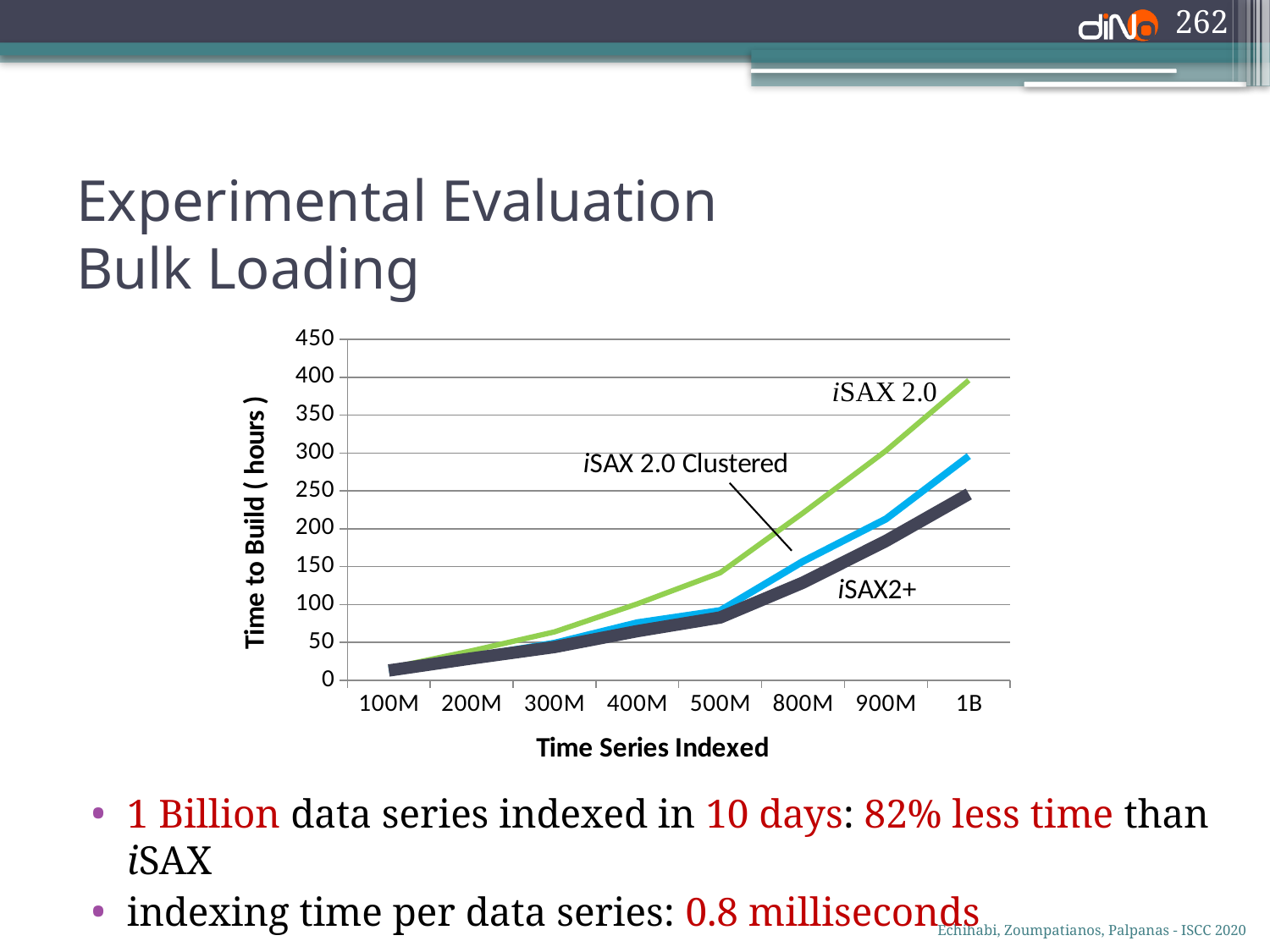
Do the values for iSAX 2.0 rise or fall as the number of time series indexed increases? rise How many categories are shown on the x axis of the chart? 8 What is the title of the y axis of the chart? Time to Build ( hours ) At 1B, which is larger: the value for iSAX 2.0 or the value for iSAX2+? iSAX 2.0 Is the value for iSAX2+ at 100M greater or less than 50? less What kind of chart is shown on the slide? line chart At 1B time series indexed, which series has the lowest time to build? iSAX2+ Is the value for iSAX2+ at 1B greater or less than 300? less How many series are plotted in the chart? 3 Is the value for iSAX 2.0 at 1B greater or less than 350? greater At 1B time series indexed, which series has the highest time to build? iSAX 2.0